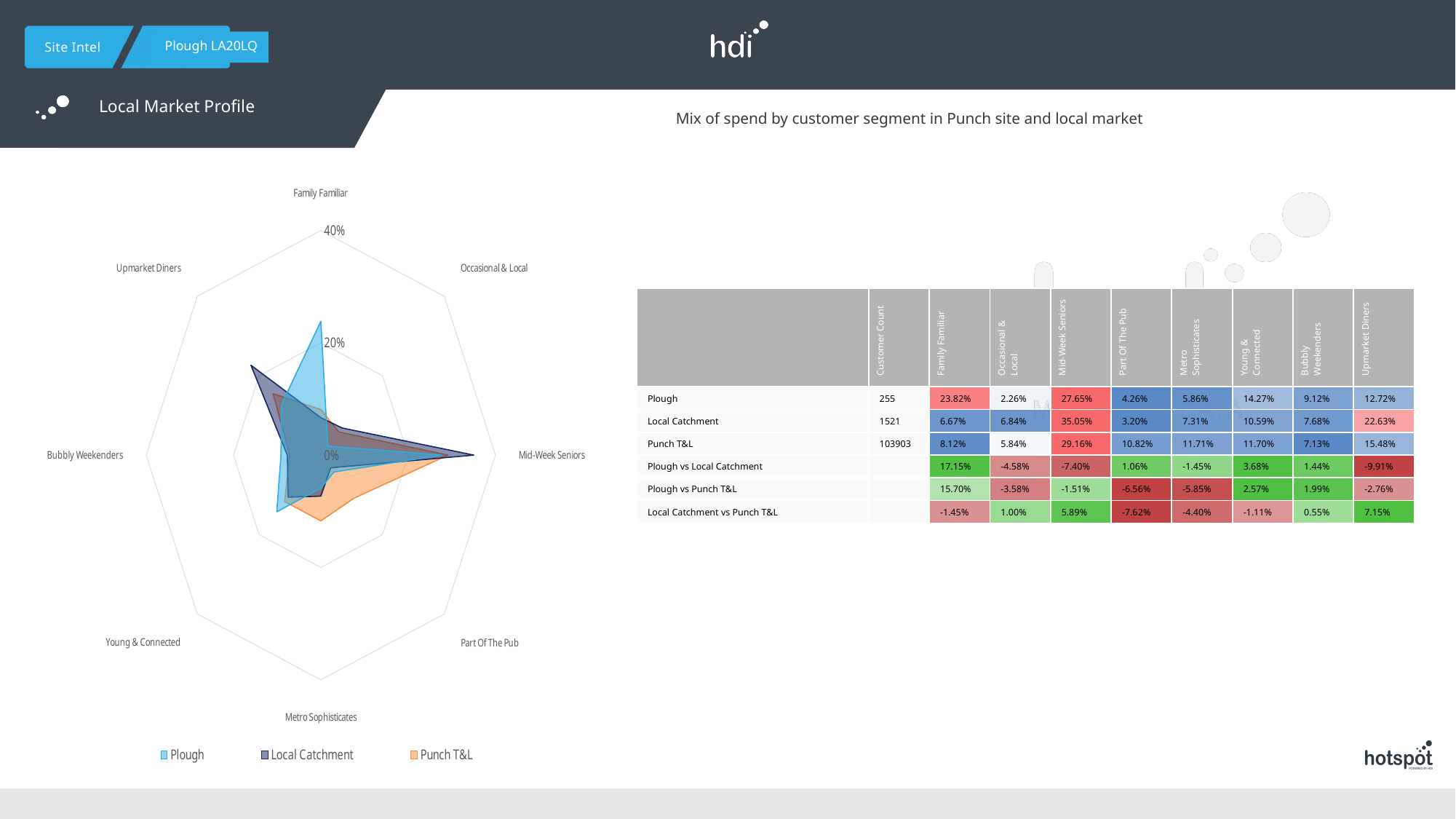
Which customer segment has the lowest value for Plough? Occasional & Local What kind of chart is shown on the left of the slide? Radar chart What is the Plough value for Family Familiar? 23.82% What is the difference between Plough and Local Catchment for Family Familiar? 17.15% Which customer segment has the highest value for Plough? Mid-Week Seniors How many series does the legend of the radar chart list? 3 Is the Plough value for Family Familiar greater or less than 20%? greater What is the Local Catchment value for Mid-Week Seniors? 35.05% What colour represents Punch T&L in the radar chart legend? Orange Is the Punch T&L value for Part Of The Pub greater or less than 20%? less For Family Familiar, which is larger: Plough or Local Catchment? Plough How many customer segments are plotted around the radar chart? 8